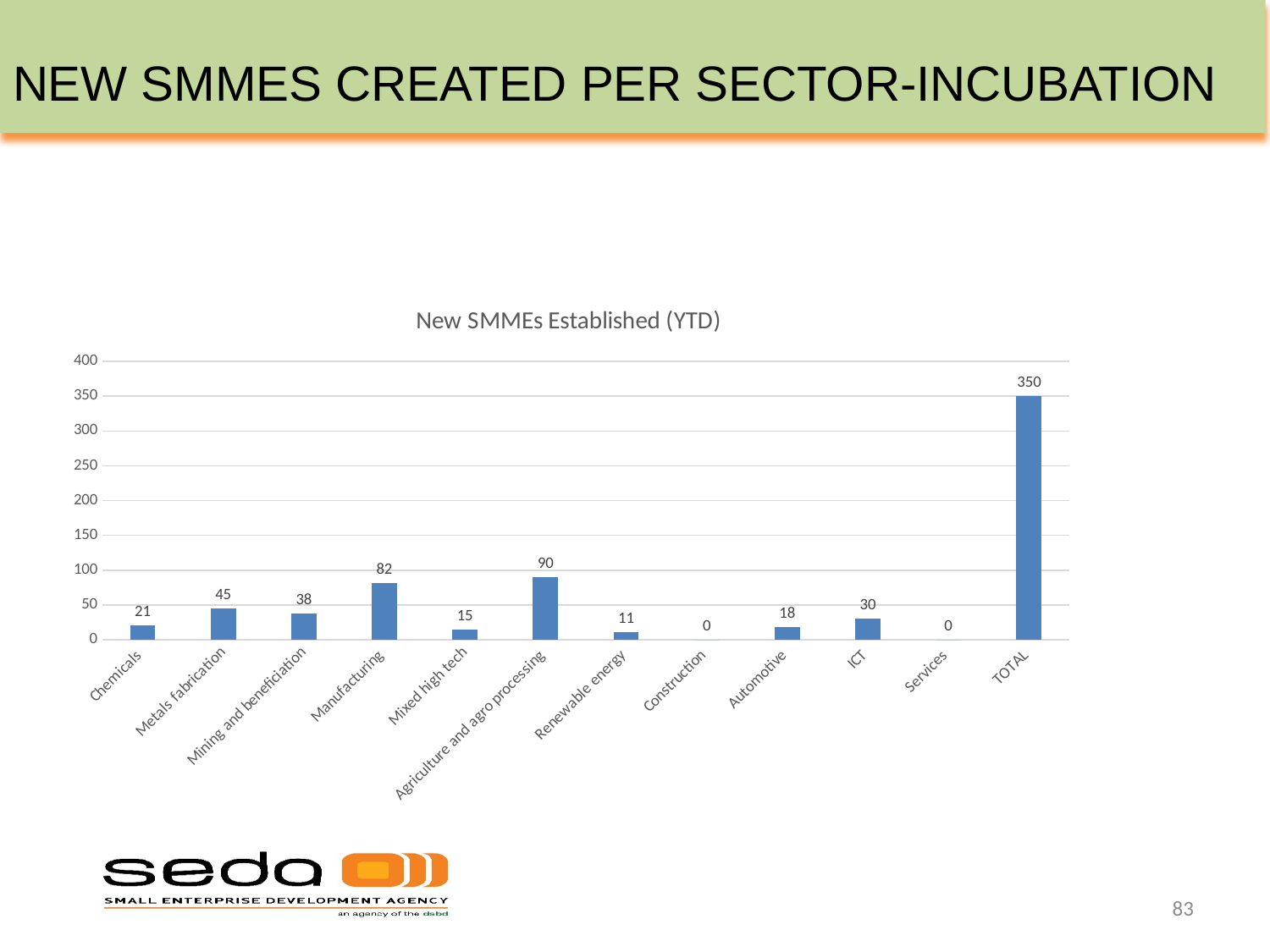
Is the value for TOTAL greater or less than 300? greater What kind of chart is shown? Bar chart How many categories are shown on the x axis, including TOTAL? 12 What is the value for Mining and beneficiation? 38 Which sectors have a value of 0? Construction and Services What is the title of the chart? New SMMEs Established (YTD) What is the value for the TOTAL bar? 350 What is the value for Agriculture and agro processing? 90 Which is larger, Metals fabrication or ICT? Metals fabrication What is the value for Manufacturing? 82 What is the difference between Agriculture and agro processing and Manufacturing? 8 Excluding the TOTAL bar, which sector has the highest value? Agriculture and agro processing